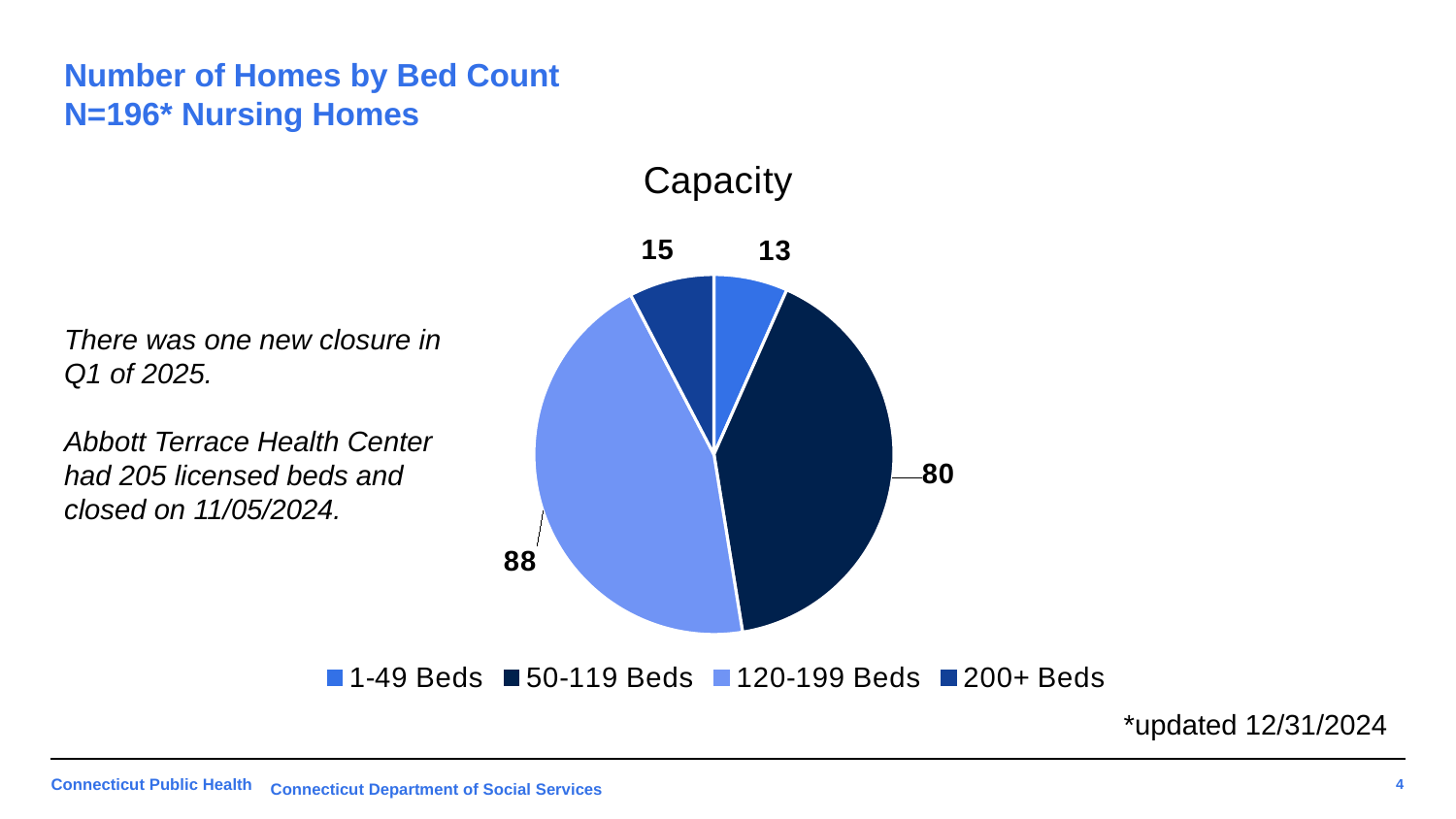
What is the total number of homes across all four slices of the pie chart? 196 What value is shown for the 200+ Beds slice? 15 How many slices does the pie chart have? 4 Which category has more homes: 200+ Beds or 1-49 Beds? 200+ Beds What type of chart is used to show the Capacity data? Pie chart Which bed-count category has the largest number of homes? 120-199 Beds What is the number of homes in the 120-199 Beds slice? 88 How many nursing homes have 50-119 beds according to the pie chart? 80 How many homes are in the 1-49 Beds category? 13 Which bed-count category has the fewest homes? 1-49 Beds What is the title of the pie chart? Capacity What is the difference between the number of homes with 120-199 beds and those with 50-119 beds? 8